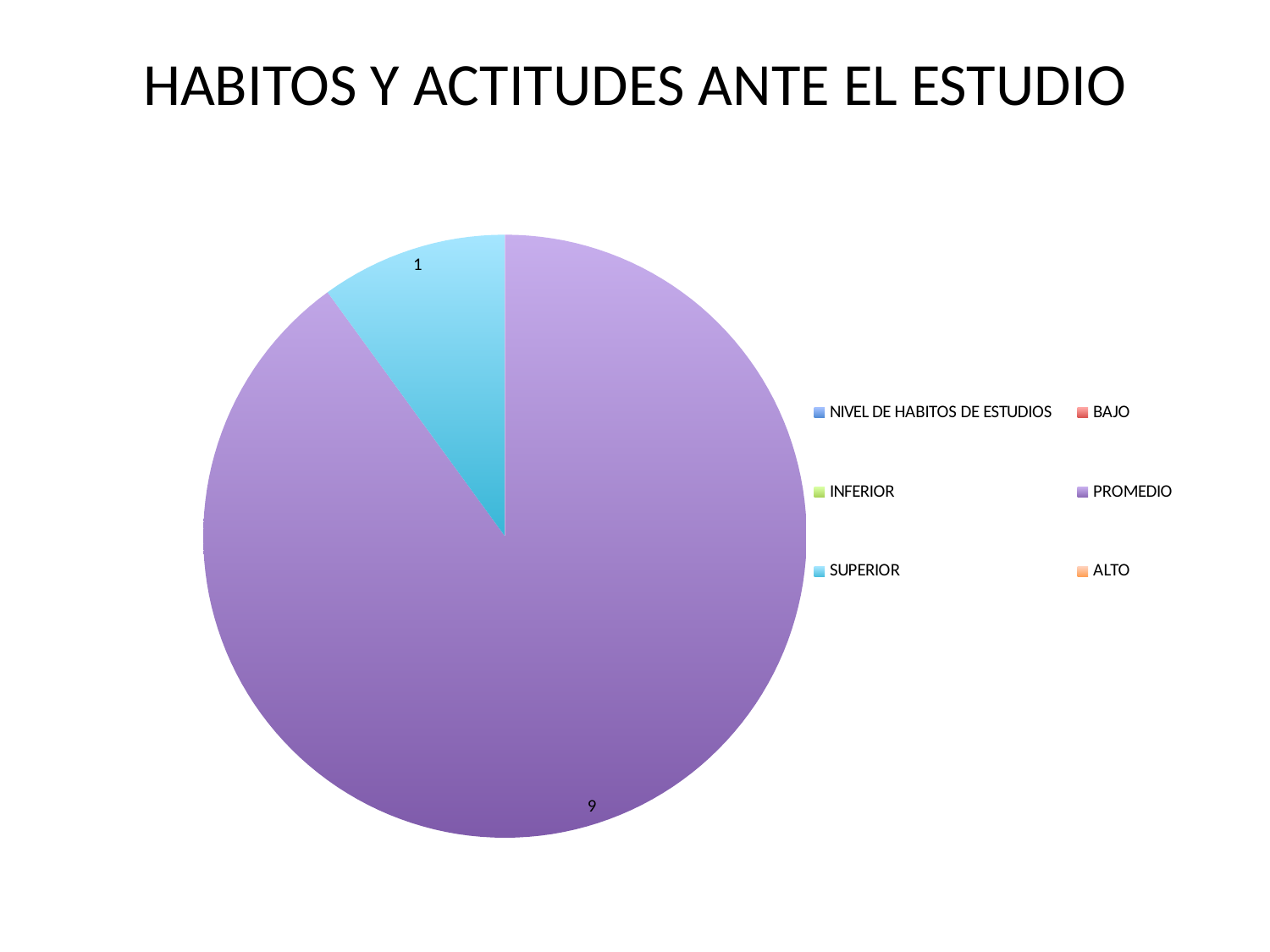
What type of chart is shown on the slide? pie chart What share of the pie does the SUPERIOR slice represent? 10% How many entries does the legend list? 6 What is the title of the slide? HABITOS Y ACTITUDES ANTE EL ESTUDIO What is the difference between the PROMEDIO value and the SUPERIOR value? 8 What is the value of the SUPERIOR slice? 1 Which category has the largest slice of the pie? PROMEDIO How many slices are visible in the pie chart? 2 What share of the pie does the PROMEDIO slice represent? 90% Which is larger, the PROMEDIO slice or the SUPERIOR slice? PROMEDIO What is the value of the PROMEDIO slice? 9 Which of the visible slices is the smallest? SUPERIOR